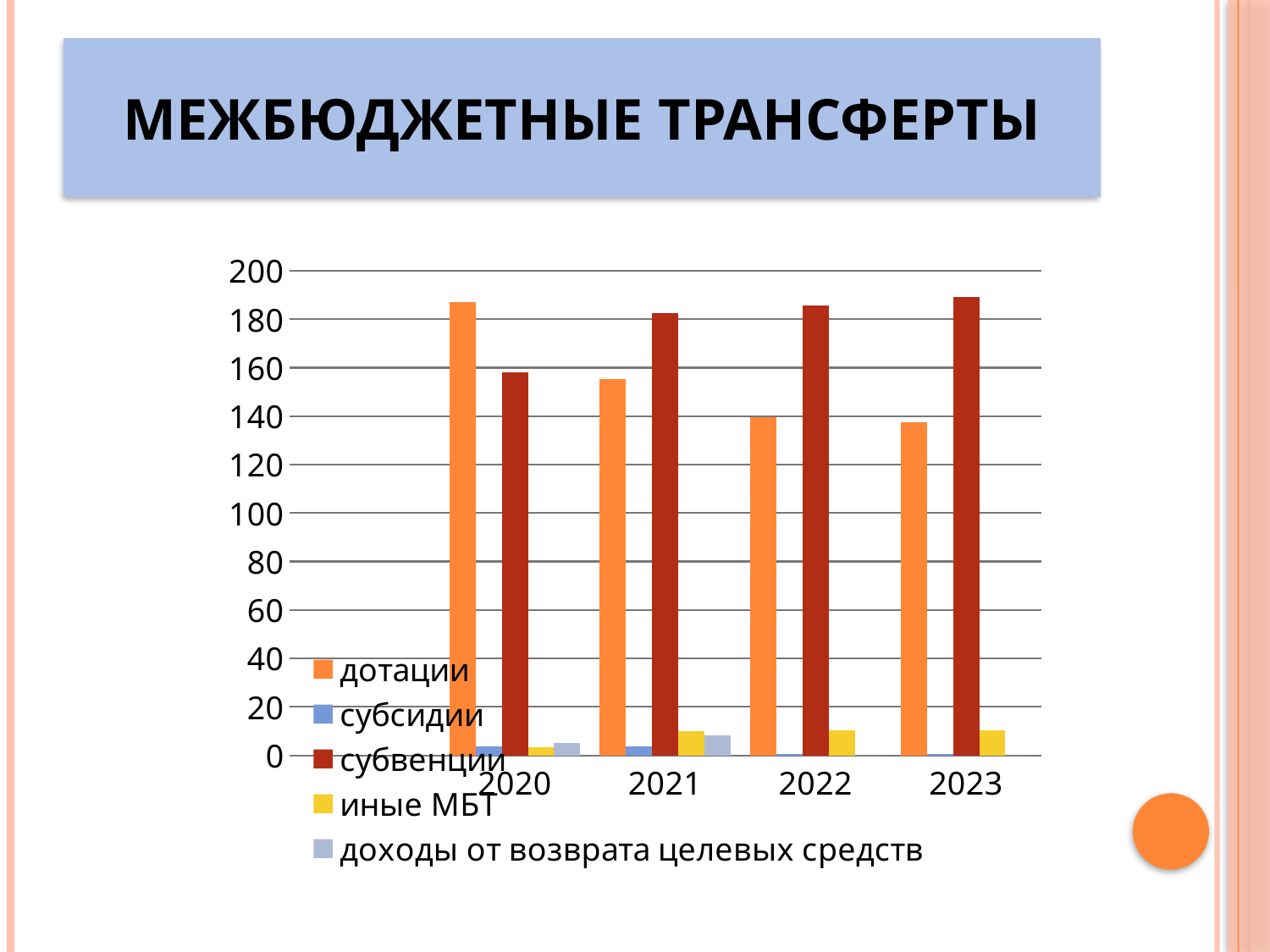
Is the value for субвенции in 2023 greater or less than 180? greater Which series is shown in dark red in the chart? субвенции In 2023, which is larger: дотации or субвенции? субвенции Do the values for дотации rise or fall from 2020 to 2023? fall What kind of chart is shown on the slide? bar chart How many series does the chart legend list? 5 Is the value for дотации in 2021 greater or less than 160? less Is the value for дотации in 2020 greater or less than 180? greater In 2020, which is larger: дотации or субвенции? дотации How many years are shown on the x axis of the chart? 4 What is the title of the slide containing the chart? МЕЖБЮДЖЕТНЫЕ ТРАНСФЕРТЫ